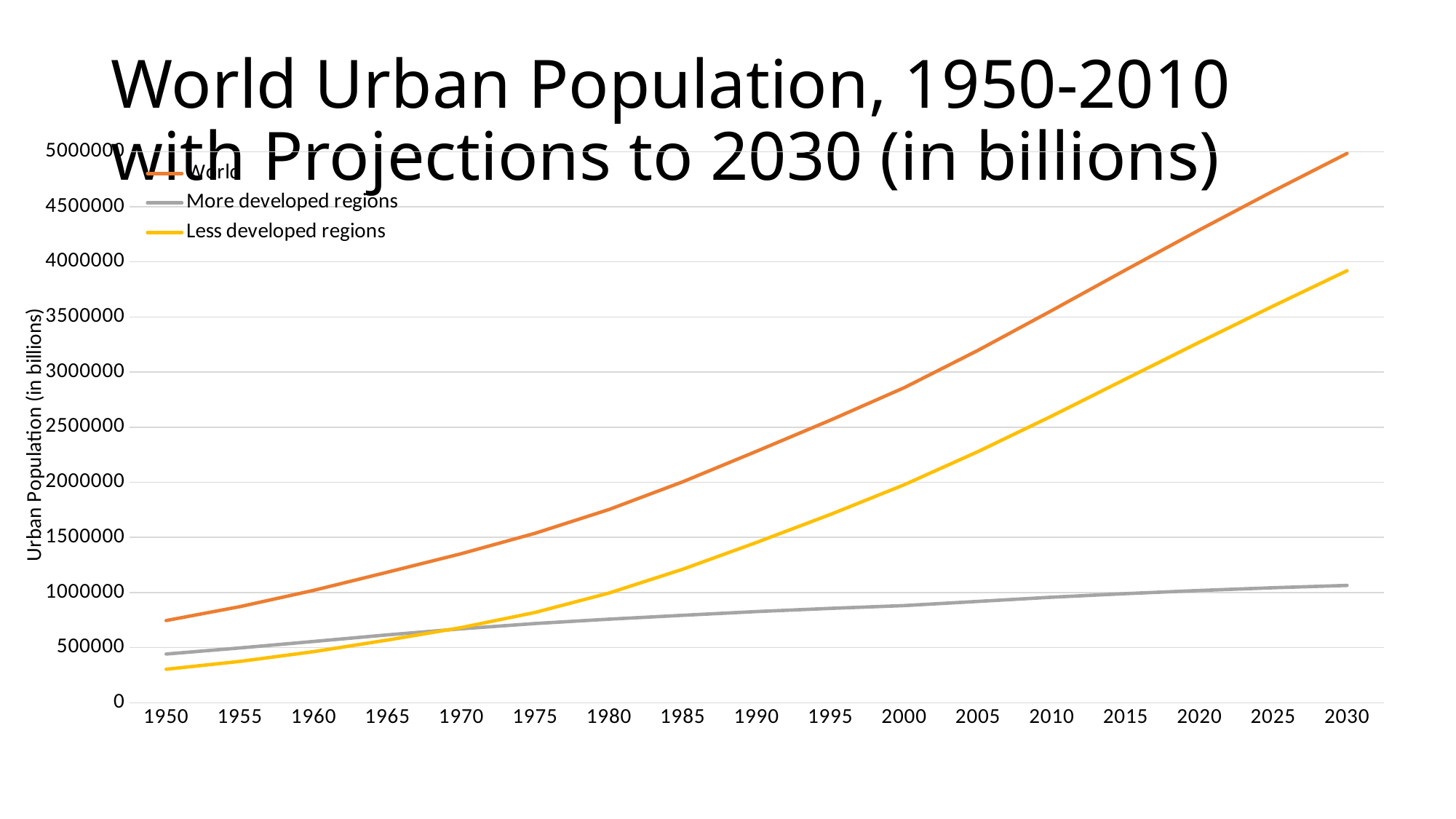
What kind of chart is shown on the slide? line chart Is the value for Less developed regions in 1950 greater or less than 500000? less Is the value for More developed regions in 2030 greater or less than 1500000? less In 2030, which is larger: More developed regions or Less developed regions? Less developed regions Is the value for World in 2000 greater or less than 2500000? greater What is the label on the y axis? Urban Population (in billions) How many years are labelled along the x axis? 17 Does the World series rise or fall from 1950 to 2030? rise Which series has the highest value in 2030? World How many series does the legend list? 3 In 1950, which is larger: More developed regions or Less developed regions? More developed regions